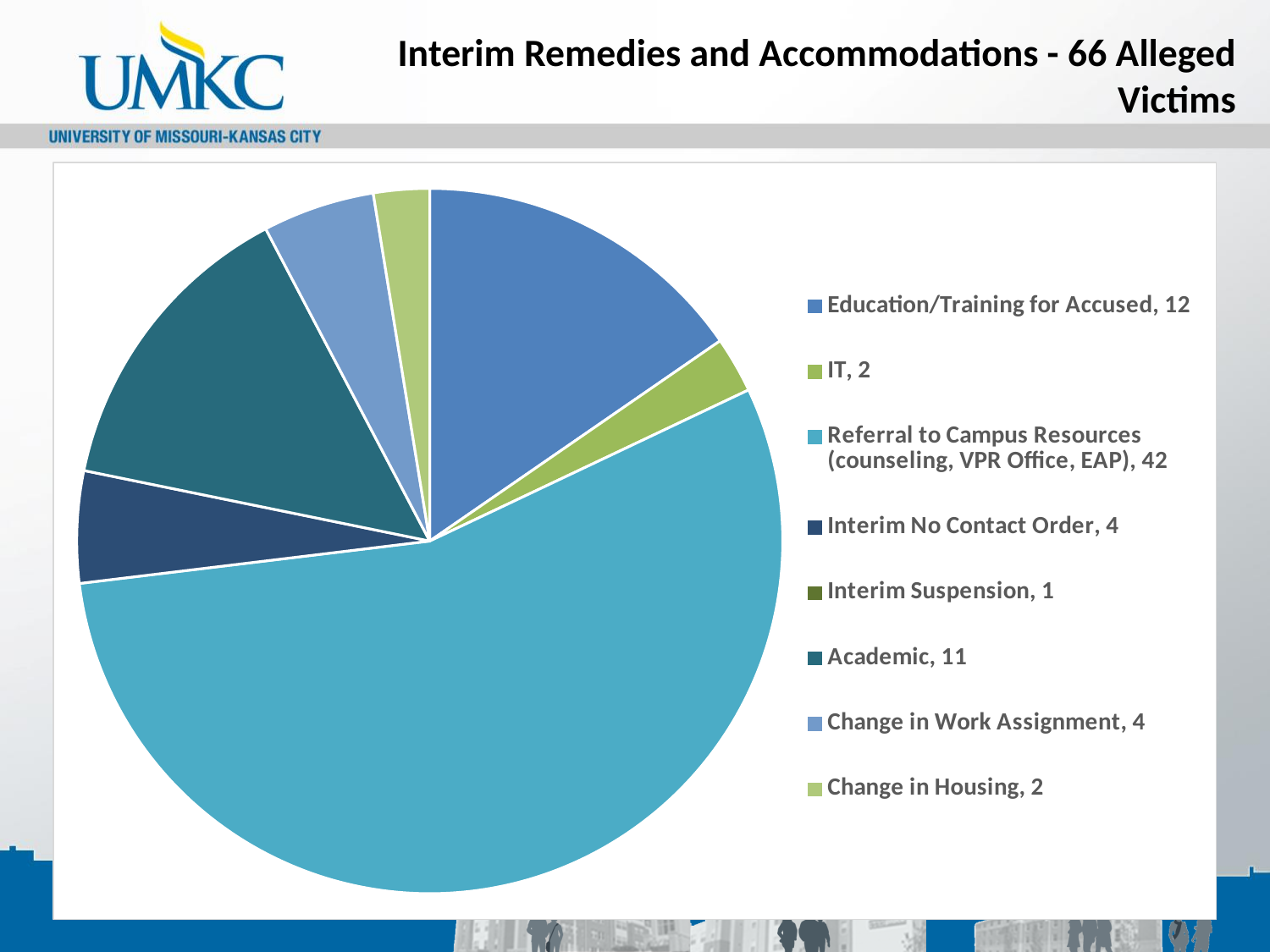
How many categories does the legend list? 8 What is the value for Academic? 11 What is the difference between the values for Referral to Campus Resources and Education/Training for Accused? 30 What is the value for Change in Work Assignment? 4 What is the value for Education/Training for Accused? 12 Which category has the largest value? Referral to Campus Resources (counseling, VPR Office, EAP) What kind of chart is shown on the slide? pie chart What is the value for Referral to Campus Resources (counseling, VPR Office, EAP)? 42 What is the value for Interim Suspension? 1 Which category has the smallest value? Interim Suspension What is the title of the chart? Interim Remedies and Accommodations - 66 Alleged Victims Which is larger, the value for Academic or the value for Interim No Contact Order? Academic